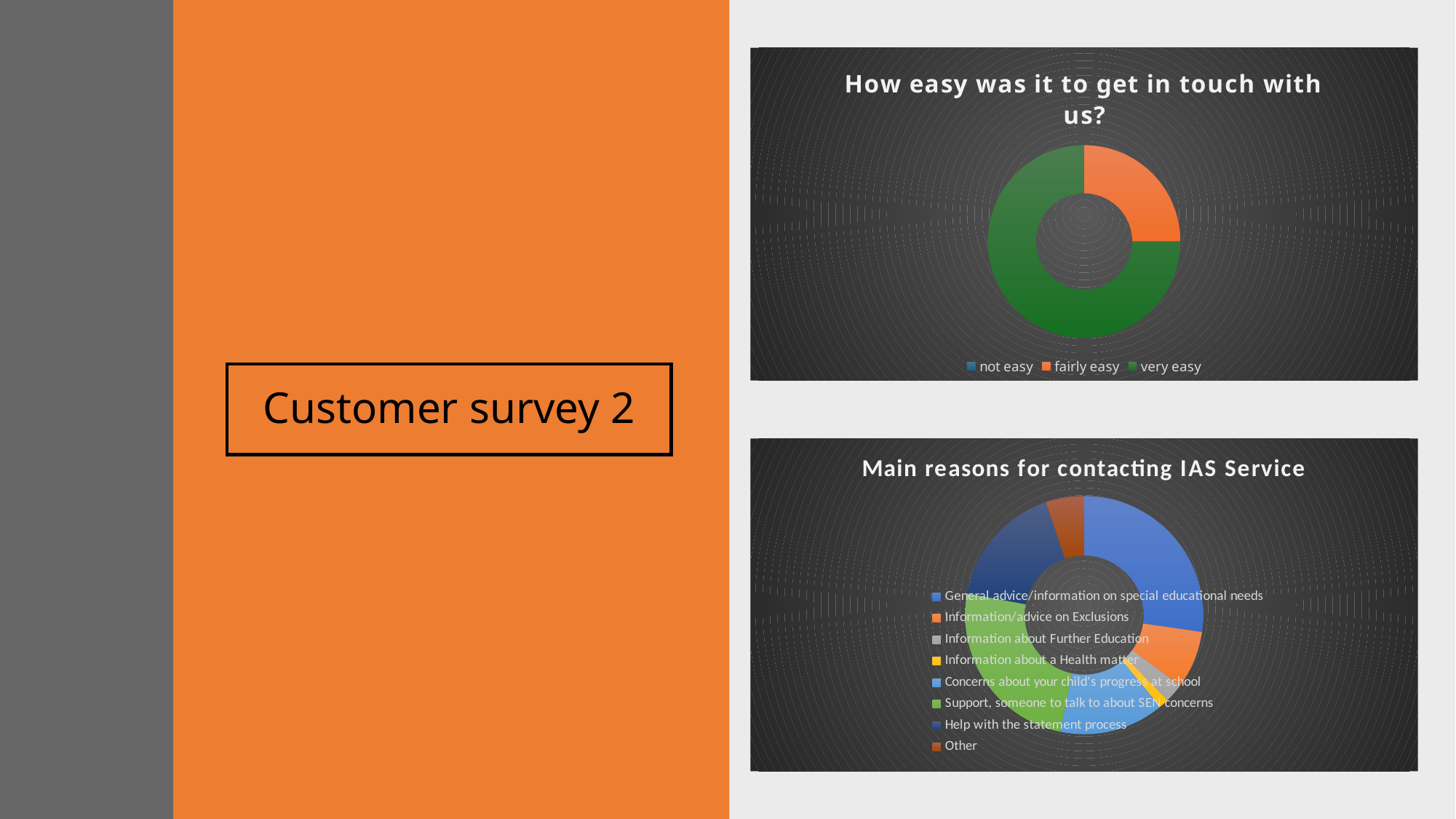
In the 'How easy was it to get in touch with us?' chart, what colour represents 'fairly easy'? orange In the 'Main reasons for contacting IAS Service' chart, how many categories does the legend list? 8 What kind of chart is the 'Main reasons for contacting IAS Service' chart? doughnut chart In the 'Main reasons for contacting IAS Service' chart, which is larger: 'General advice/information on special educational needs' or 'Information/advice on Exclusions'? General advice/information on special educational needs What kind of chart is the 'How easy was it to get in touch with us?' chart? doughnut chart In the 'How easy was it to get in touch with us?' chart, how many categories does the legend list? 3 In the 'How easy was it to get in touch with us?' chart, which category has the largest share? very easy What is the title of the top chart on the slide? How easy was it to get in touch with us? In the 'How easy was it to get in touch with us?' chart, which is larger: 'very easy' or 'fairly easy'? very easy In the 'Main reasons for contacting IAS Service' chart, which is larger: 'Help with the statement process' or 'Other'? Help with the statement process